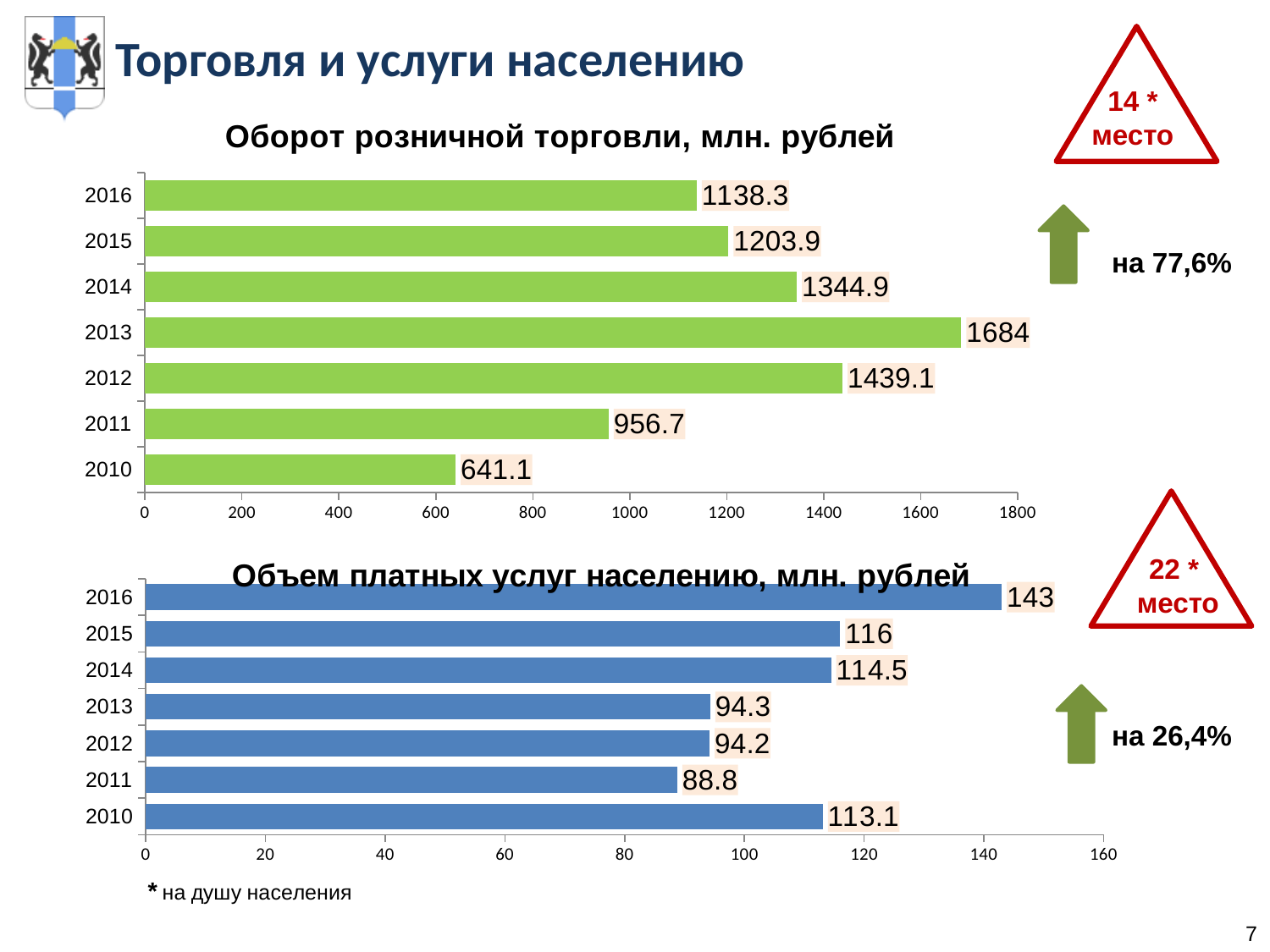
In the chart 'Объем платных услуг населению, млн. рублей', what is the value for 2011? 88.8 In the chart 'Оборот розничной торговли, млн. рублей', what is the value for 2013? 1684 In the chart 'Оборот розничной торговли, млн. рублей', which year has the highest value? 2013 In the chart 'Объем платных услуг населению, млн. рублей', which year has the lowest value? 2011 In the chart 'Объем платных услуг населению, млн. рублей', what is the value for 2016? 143 In the chart 'Оборот розничной торговли, млн. рублей', how many years are shown? 7 In the chart 'Оборот розничной торговли, млн. рублей', what is the difference between the values for 2012 and 2011? 482.4 In the chart 'Оборот розничной торговли, млн. рублей', what is the value for 2010? 641.1 What type of chart is the bottom chart 'Объем платных услуг населению, млн. рублей'? bar chart In the chart 'Оборот розничной торговли, млн. рублей', which year has the lowest value? 2010 In the chart 'Объем платных услуг населению, млн. рублей', which is larger, the value for 2010 or the value for 2015? 2015 In the chart 'Объем платных услуг населению, млн. рублей', what is the difference between the values for 2016 and 2015? 27